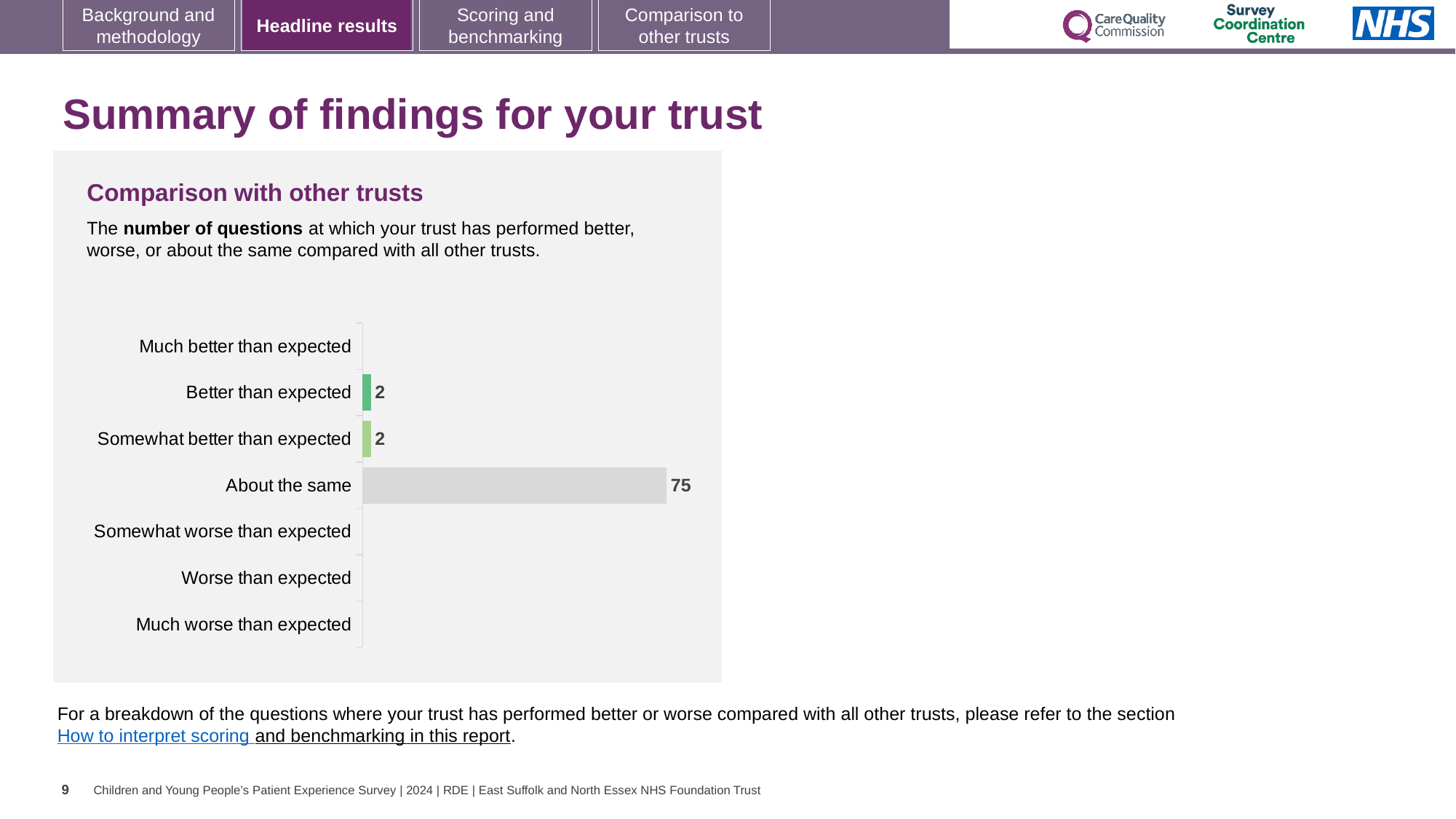
What is the value for 'Somewhat better than expected'? 2 How many categories are listed on the chart's axis? 7 What is the value for 'Better than expected'? 2 What is the title of the chart? Comparison with other trusts Which category has the highest value? About the same What is the difference between the values for 'About the same' and 'Better than expected'? 73 What is the total of the values for 'Better than expected', 'Somewhat better than expected' and 'About the same'? 79 Which is larger, the value for 'About the same' or the value for 'Somewhat better than expected'? About the same What kind of chart is shown on the slide? Bar chart What colour is the bar for 'About the same'? Grey What is the value for 'About the same'? 75